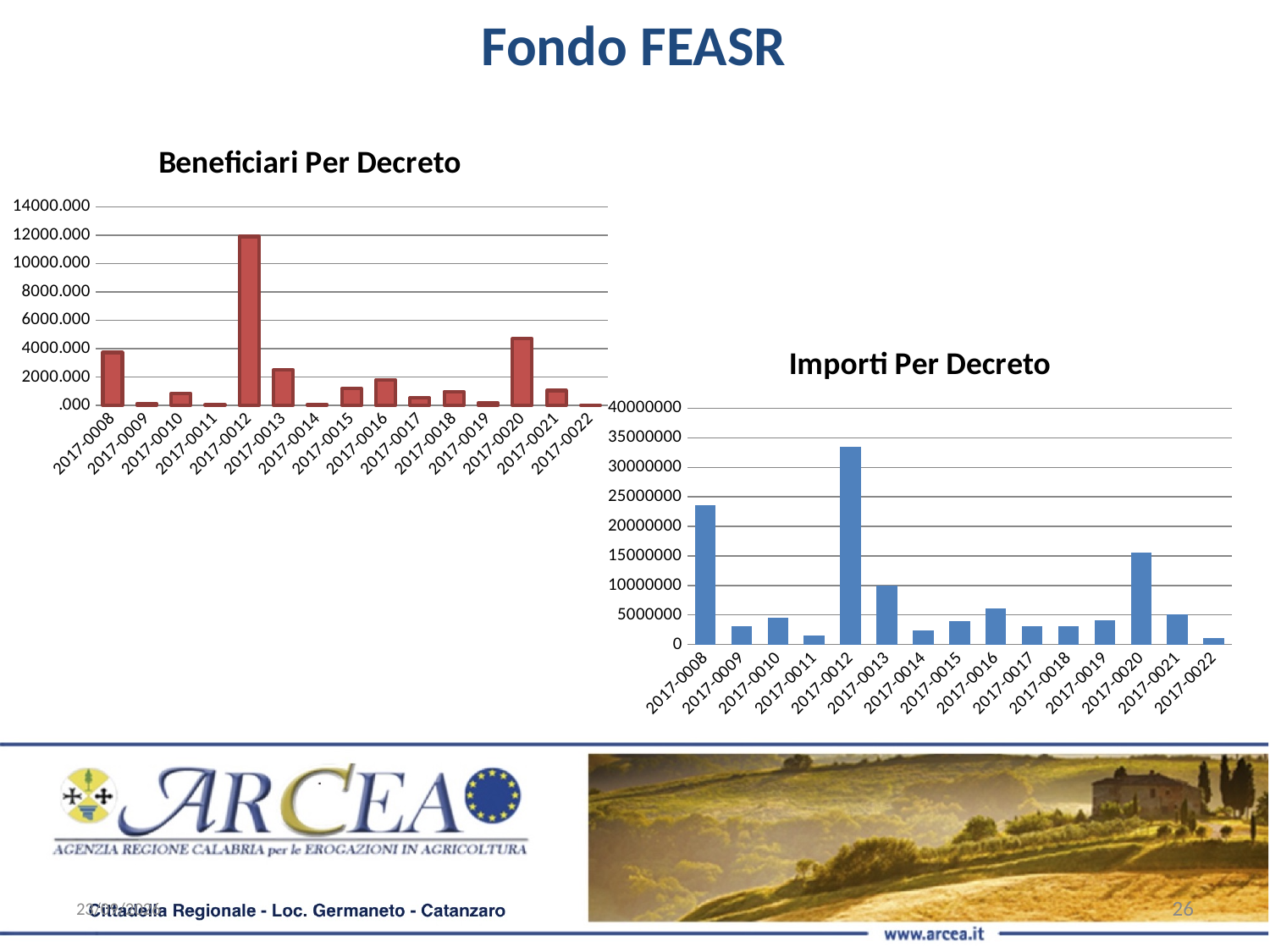
In the 'Importi Per Decreto' chart, which decreto has the highest value? 2017-0012 In the 'Importi Per Decreto' chart, is the value for 2017-0012 greater or less than 30000000? greater In the 'Beneficiari Per Decreto' chart, is the value for 2017-0020 greater or less than 4000.000? greater How many decreti are shown on the x axis of the 'Importi Per Decreto' chart? 15 What kind of chart is 'Beneficiari Per Decreto'? Bar chart In the 'Importi Per Decreto' chart, is the value for 2017-0008 greater or less than 20000000? greater In the 'Beneficiari Per Decreto' chart, which decreto has the highest value? 2017-0012 In the 'Importi Per Decreto' chart, which is larger, the value for 2017-0008 or 2017-0020? 2017-0008 In the 'Beneficiari Per Decreto' chart, which is larger, the value for 2017-0008 or 2017-0020? 2017-0020 What colour are the bars in the 'Importi Per Decreto' chart? Blue